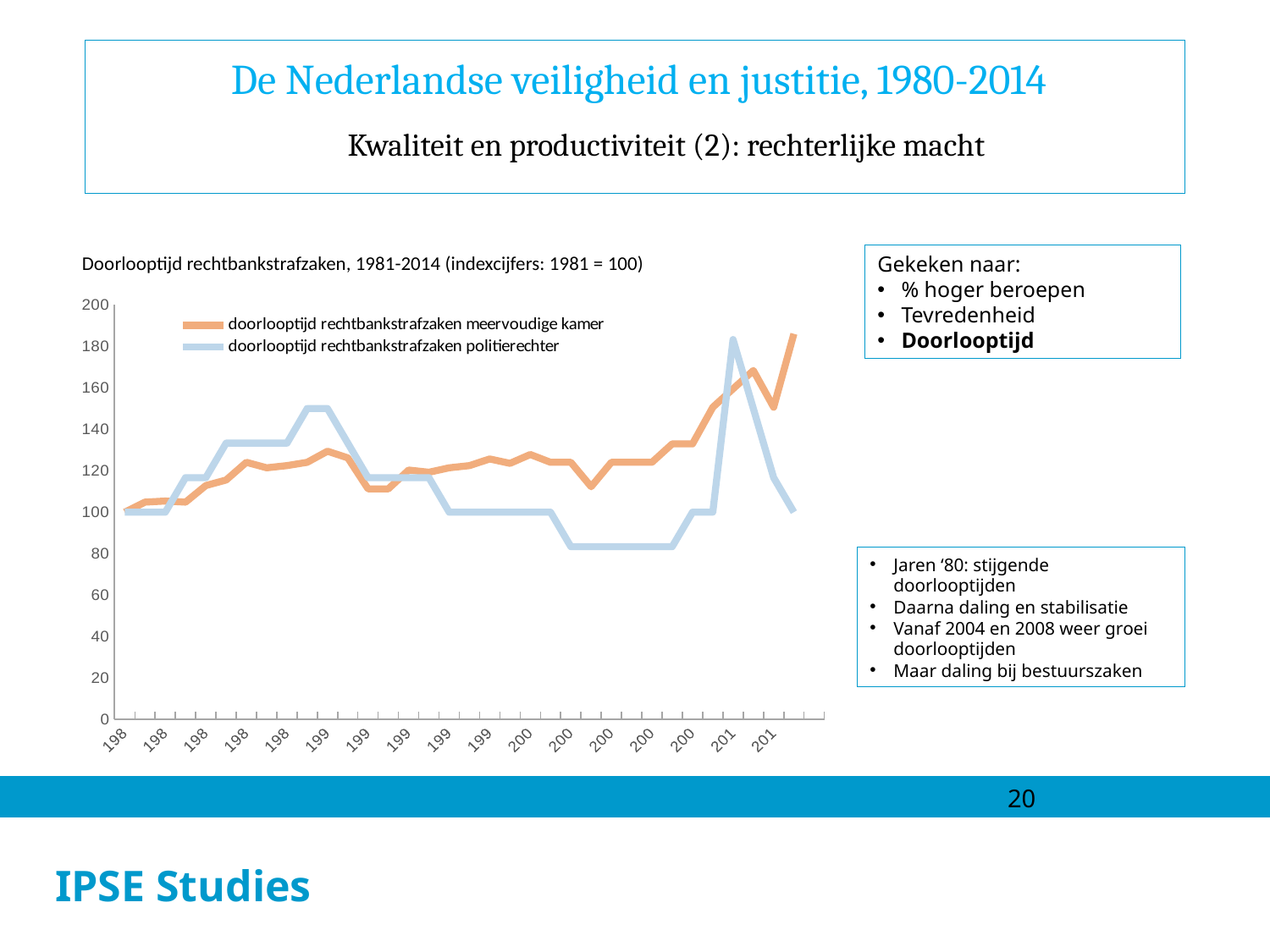
Does the 'doorlooptijd rechtbankstrafzaken meervoudige kamer' series end higher or lower than it starts? higher Is the highest value reached by the 'doorlooptijd rechtbankstrafzaken politierechter' series greater or less than 160? greater Is the lowest value reached by the 'doorlooptijd rechtbankstrafzaken politierechter' series greater or less than 100? less What kind of chart is shown on the slide? line chart Which series drops to a lower minimum value over the period, meervoudige kamer or politierechter? politierechter How many series does the chart's legend list? 2 What is the title of the chart? Doorlooptijd rechtbankstrafzaken, 1981-2014 (indexcijfers: 1981 = 100) Is the final value of the 'doorlooptijd rechtbankstrafzaken politierechter' series greater or less than 120? less What is the maximum value shown on the chart's vertical axis? 200 Which series is drawn in orange in the chart? doorlooptijd rechtbankstrafzaken meervoudige kamer What is the index value of both series in the base year 1981, according to the chart title? 100